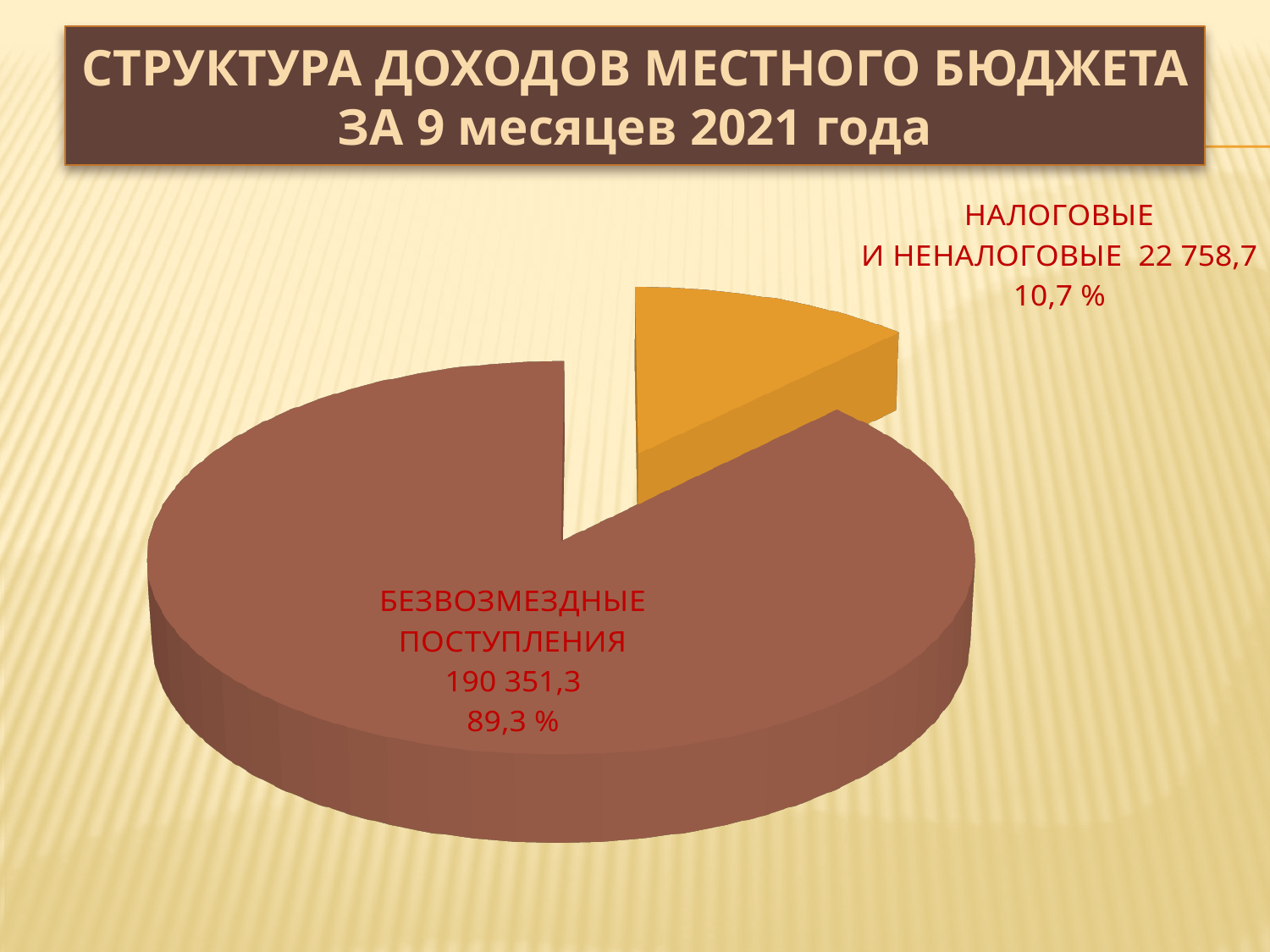
How many slices does the pie chart have? 2 What colour is the slice for НАЛОГОВЫЕ И НЕНАЛОГОВЫЕ? Orange Which slice of the pie is the largest? БЕЗВОЗМЕЗДНЫЕ ПОСТУПЛЕНИЯ What is the difference between the values for БЕЗВОЗМЕЗДНЫЕ ПОСТУПЛЕНИЯ and НАЛОГОВЫЕ И НЕНАЛОГОВЫЕ? 167 592,6 What is the total of the two values shown on the pie chart? 213 110,0 What share of the pie does БЕЗВОЗМЕЗДНЫЕ ПОСТУПЛЕНИЯ represent? 89,3 % What value is shown for БЕЗВОЗМЕЗДНЫЕ ПОСТУПЛЕНИЯ? 190 351,3 Which is larger, БЕЗВОЗМЕЗДНЫЕ ПОСТУПЛЕНИЯ or НАЛОГОВЫЕ И НЕНАЛОГОВЫЕ? БЕЗВОЗМЕЗДНЫЕ ПОСТУПЛЕНИЯ What share of the pie does НАЛОГОВЫЕ И НЕНАЛОГОВЫЕ represent? 10,7 % What value is shown for НАЛОГОВЫЕ И НЕНАЛОГОВЫЕ? 22 758,7 What kind of chart is shown on the slide? Pie chart Which slice of the pie is the smallest? НАЛОГОВЫЕ И НЕНАЛОГОВЫЕ